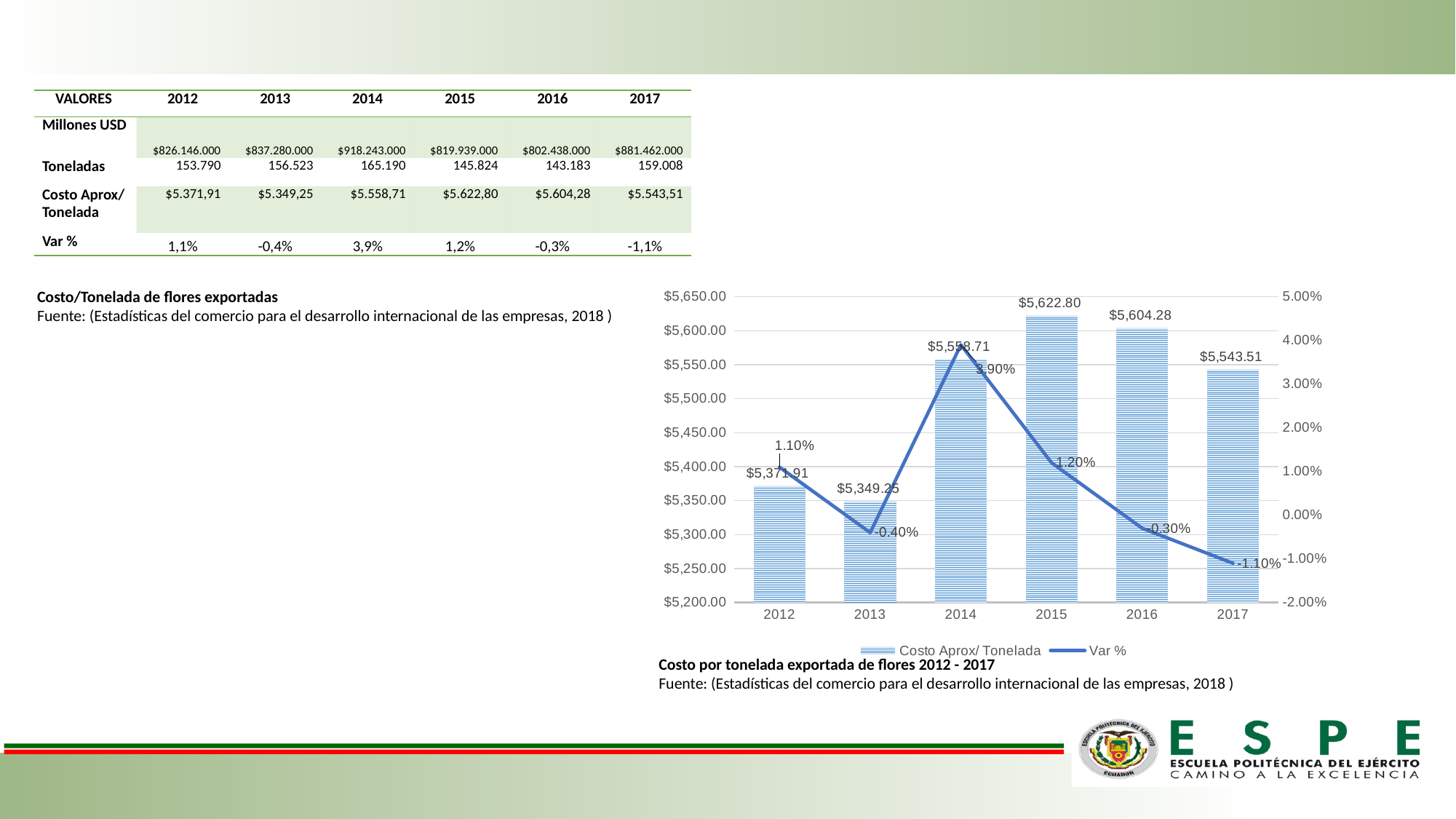
Which year has the highest Costo Aprox/ Tonelada? 2015 How many years are shown on the x axis of the chart? 6 Which year has the lowest Var %? 2017 How many series does the chart legend list? 2 What is the Costo Aprox/ Tonelada value for 2015? $5,622.80 What kind of chart is shown on the slide? Combined bar and line chart What is the Var % value for 2014? 3.90% Which year has the lowest Costo Aprox/ Tonelada? 2013 What is the Costo Aprox/ Tonelada value for 2013? $5,349.25 Which is larger, the Costo Aprox/ Tonelada for 2016 or for 2017? 2016 What is the difference between the Costo Aprox/ Tonelada for 2015 and 2013? $273.55 What is the title of the chart? Costo por tonelada exportada de flores 2012 - 2017